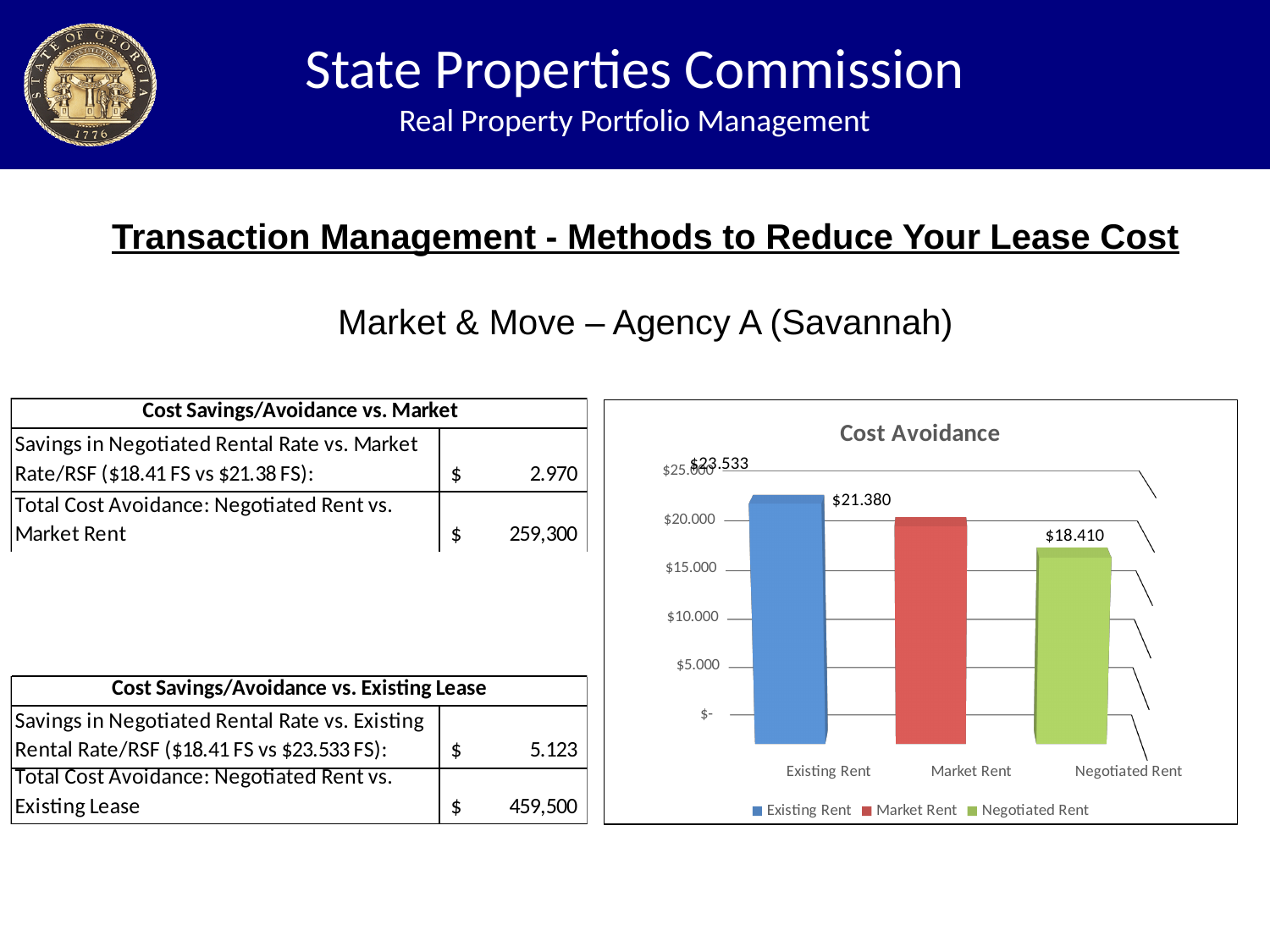
What is the value shown for Existing Rent in the Cost Avoidance chart? $23.533 Which category has the highest value in the Cost Avoidance chart? Existing Rent What is the difference between the Market Rent and Negotiated Rent values in the Cost Avoidance chart? $2.970 How many bars are plotted in the Cost Avoidance chart? 3 Which category has the lowest value in the Cost Avoidance chart? Negotiated Rent What is the value shown for Market Rent in the Cost Avoidance chart? $21.380 What is the value shown for Negotiated Rent in the Cost Avoidance chart? $18.410 Do the values rise or fall from left to right across the Cost Avoidance chart? fall What is the difference between the Existing Rent and Negotiated Rent values in the Cost Avoidance chart? $5.123 What type of chart is shown on the slide? bar chart Which is larger in the Cost Avoidance chart, Existing Rent or Market Rent? Existing Rent What is the title of the chart? Cost Avoidance